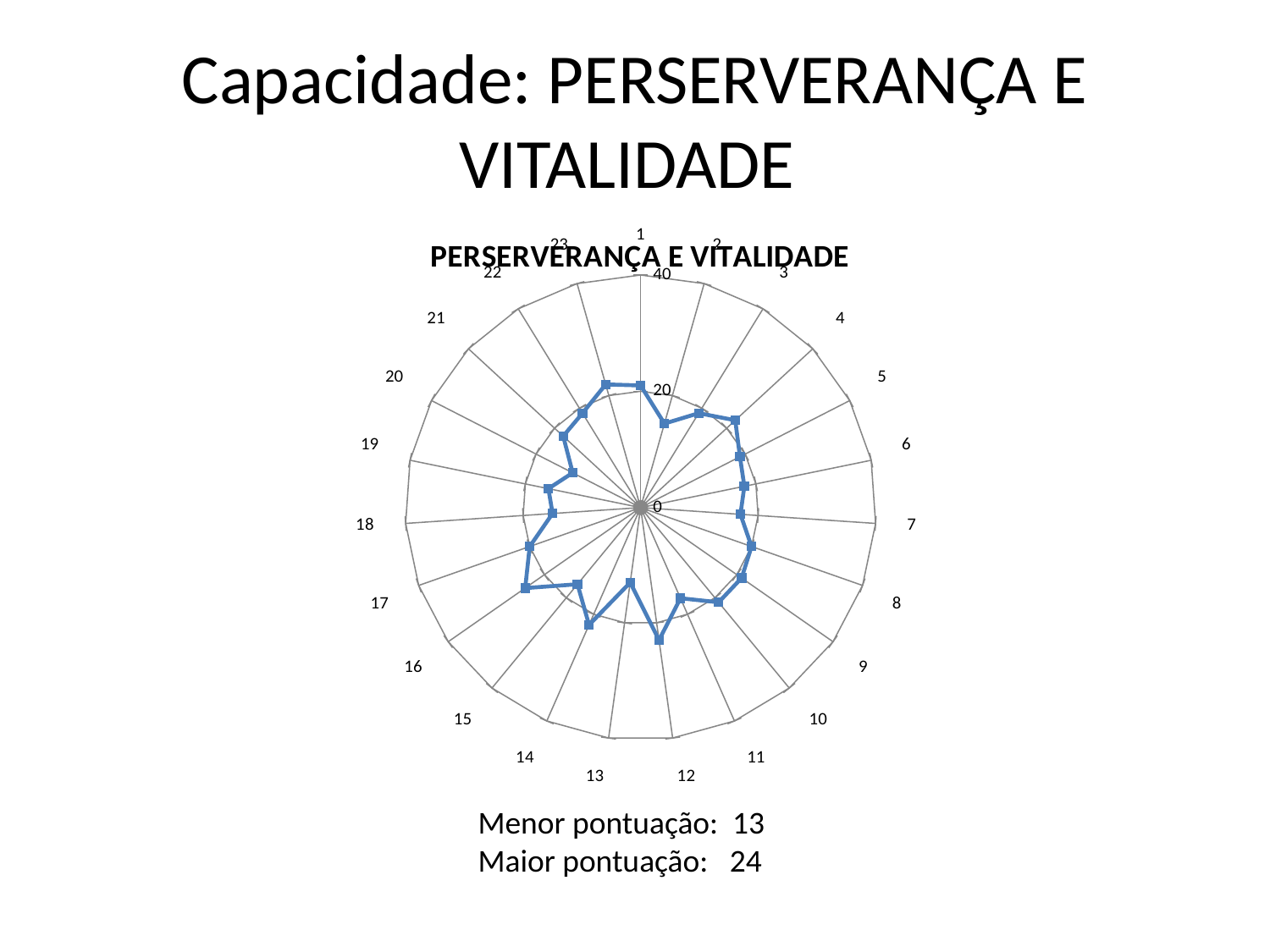
What kind of chart is shown on the slide? Radar chart Is the value for category 7 greater or less than 20? less Is the value for category 12 greater or less than 20? greater What is the title of the chart? PERSERVERANÇA E VITALIDADE Which has the larger value, category 16 or category 13? Category 16 Is the value for category 18 greater or less than 20? less How many categories (axes) does the radar chart have? 23 How many data series are plotted on the radar chart? 1 What is the highest value shown on the radial axis of the chart? 40